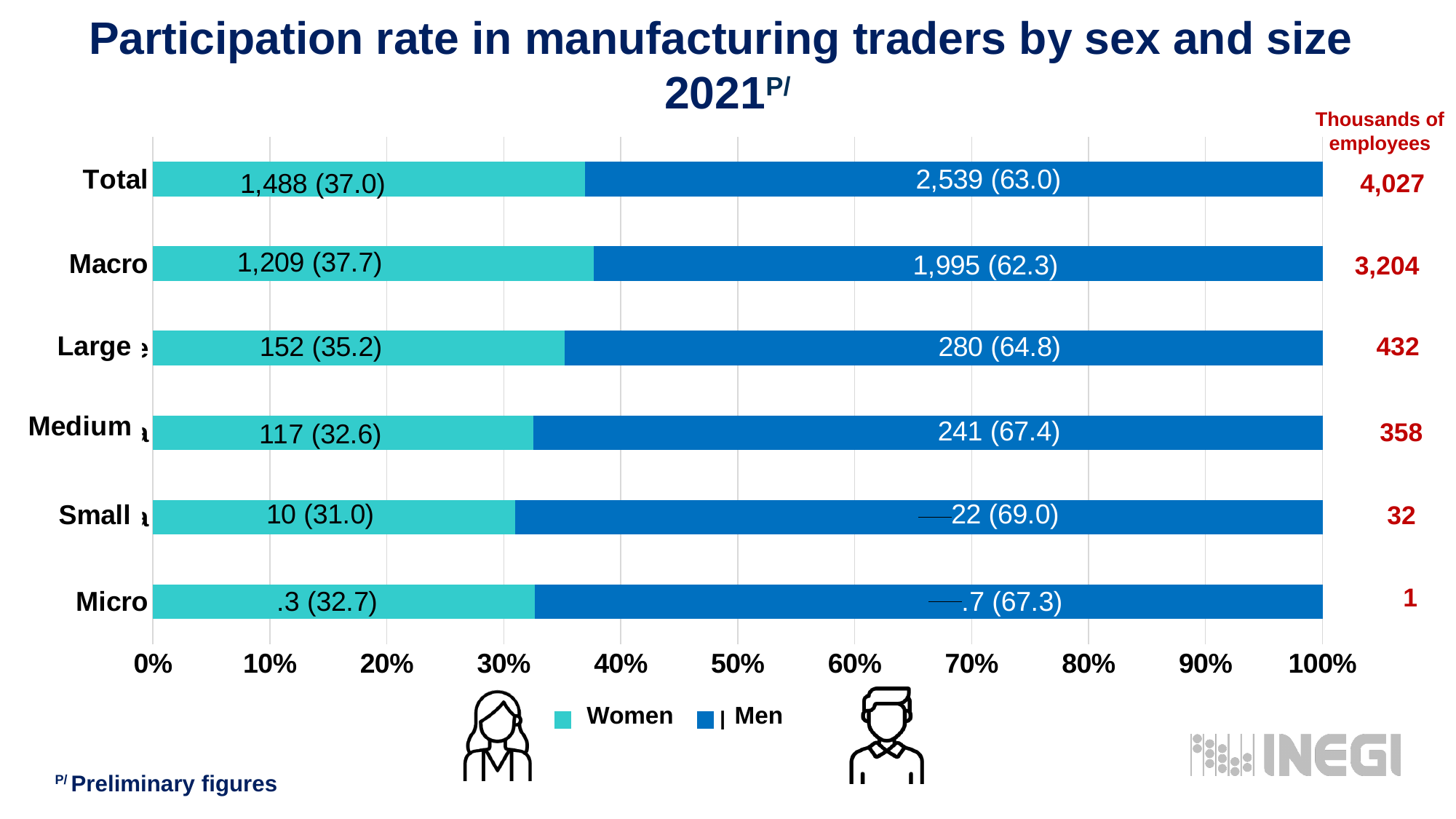
What percentage of the Medium bar is Men? 67.4 Which category has the highest percentage for Women? Macro Which category has the lowest percentage for Women? Small How many series does the legend list? 2 In the Total bar, how much larger is the Men value than the Women value (in thousands)? 1,051 How many thousands of employees are shown for Large? 432 Is the Women share of the Small bar greater or less than 40%? less What is the data label for Women in the Total bar? 1,488 (37.0) How many size categories are plotted on the chart? 6 Which has a larger Women percentage, Large or Medium? Large What kind of chart is shown on the slide? Stacked bar chart What is the total thousands of employees shown for Macro? 3,204